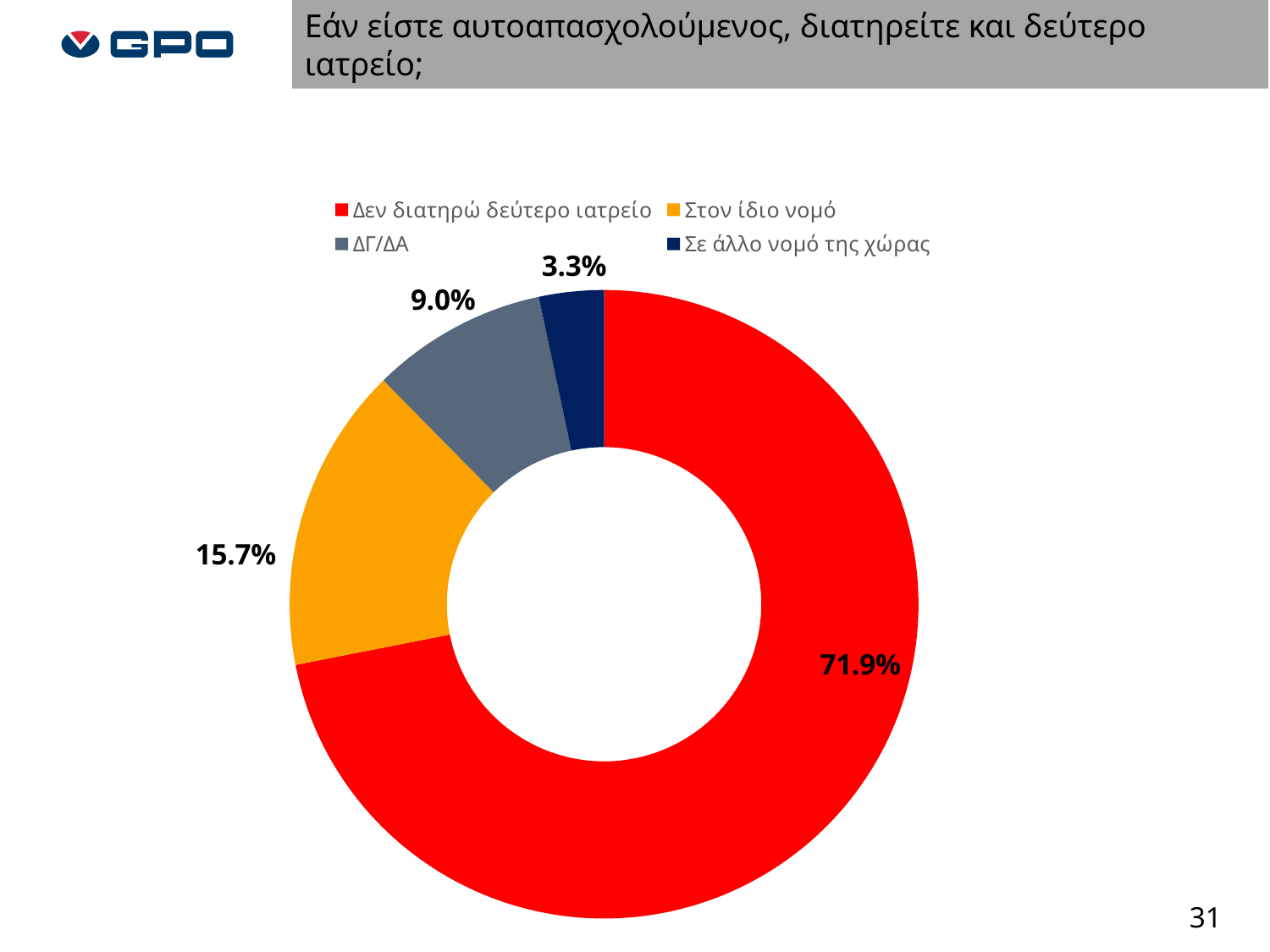
What percentage of respondents answered "Δεν διατηρώ δεύτερο ιατρείο"? 71.9% What colour represents "Δεν διατηρώ δεύτερο ιατρείο" in the chart? Red What is the value shown for "Στον ίδιο νομό"? 15.7% Which is larger: the share for "ΔΓ/ΔΑ" or the share for "Στον ίδιο νομό"? Στον ίδιο νομό What type of chart is shown on the slide? Doughnut (pie) chart What percentage is shown for "ΔΓ/ΔΑ"? 9.0% What is the combined share of "Στον ίδιο νομό" and "Σε άλλο νομό της χώρας"? 19.0% How many categories are shown in the chart? 4 Which category has the largest share of the chart? Δεν διατηρώ δεύτερο ιατρείο Which category has the smallest share of the chart? Σε άλλο νομό της χώρας What is the value for "Σε άλλο νομό της χώρας"? 3.3% What is the difference in percentage points between "Στον ίδιο νομό" and "Σε άλλο νομό της χώρας"? 12.4